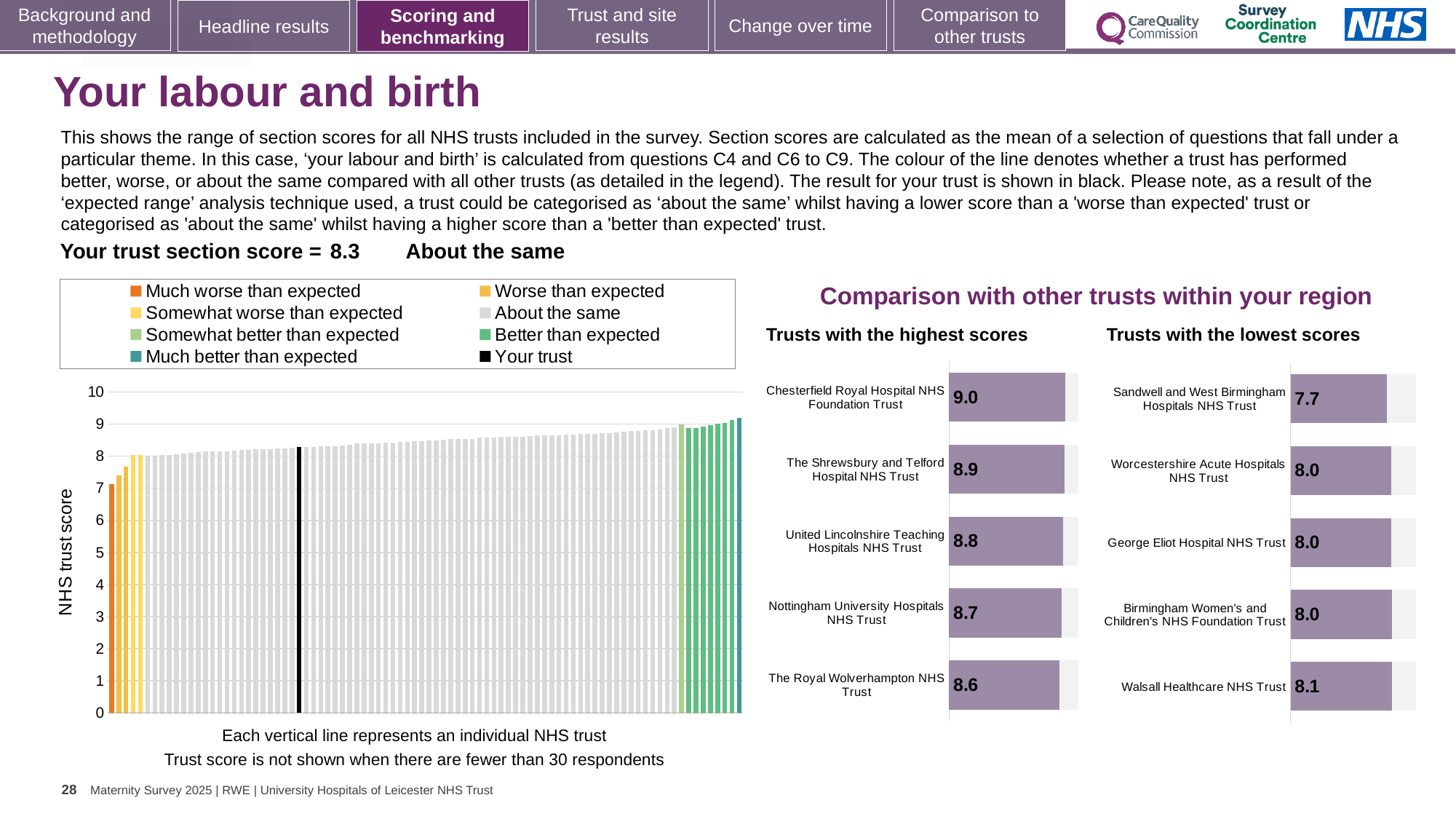
Comparing the two regional charts, which has the higher score: Nottingham University Hospitals NHS Trust or Walsall Healthcare NHS Trust? Nottingham University Hospitals NHS Trust In the 'Trusts with the lowest scores' chart, which trust has the highest score shown? Walsall Healthcare NHS Trust In the 'Trusts with the lowest scores' chart, what is the score for Sandwell and West Birmingham Hospitals NHS Trust? 7.7 What kind of chart is the main chart on the left showing NHS trust scores? Bar chart In the 'Trusts with the highest scores' chart, what is the difference between the scores of Chesterfield Royal Hospital NHS Foundation Trust and The Royal Wolverhampton NHS Trust? 0.4 In the 'Trusts with the lowest scores' chart, how many trusts have a score of 8.0? 3 How many entries does the legend of the main 'NHS trust score' chart list? 8 In the 'Trusts with the highest scores' chart, which trust has the lowest score shown? The Royal Wolverhampton NHS Trust How many trusts are listed in the 'Trusts with the lowest scores' chart? 5 In the 'Trusts with the highest scores' chart, what is the score for Chesterfield Royal Hospital NHS Foundation Trust? 9.0 In the main 'NHS trust score' chart, do the bar values rise or fall from left to right? Rise In the main 'NHS trust score' chart, is the value of the leftmost (orange) bar greater or less than 8? less